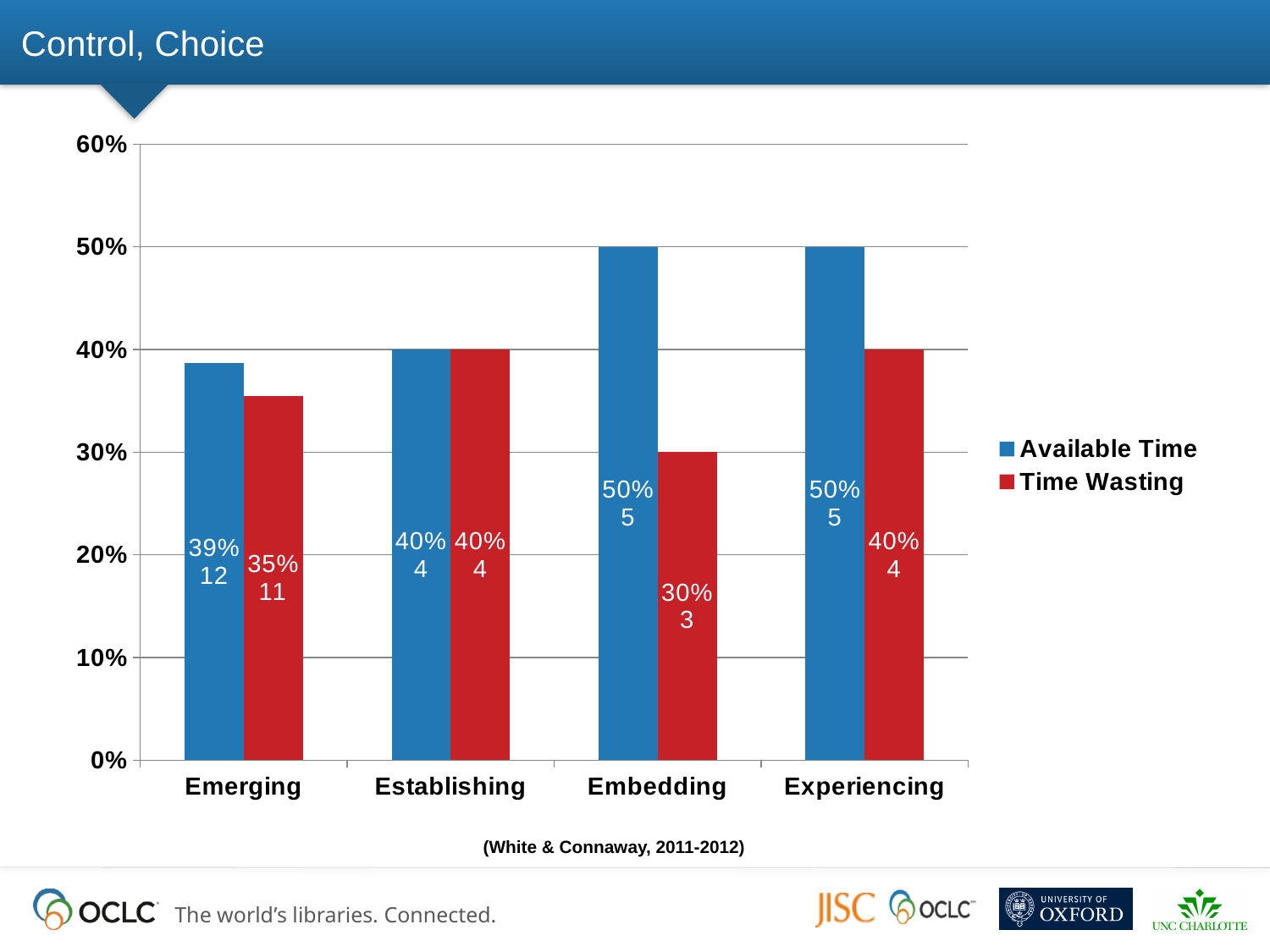
How many series does the legend list? 2 Which category has the lowest Time Wasting value? Embedding What is the Time Wasting value for Embedding? 30% Is the Available Time value for Embedding greater or less than 40%? greater What is the difference between the Available Time and Time Wasting values for Emerging? 4% Which category has the lowest Available Time value? Emerging How many categories are shown on the x axis? 4 What is the difference between the Available Time and Time Wasting values for Embedding? 20% What is the Time Wasting value for Experiencing? 40% What kind of chart is shown on the slide? bar chart Which is larger for Experiencing, Available Time or Time Wasting? Available Time What is the Available Time value for Emerging? 39%